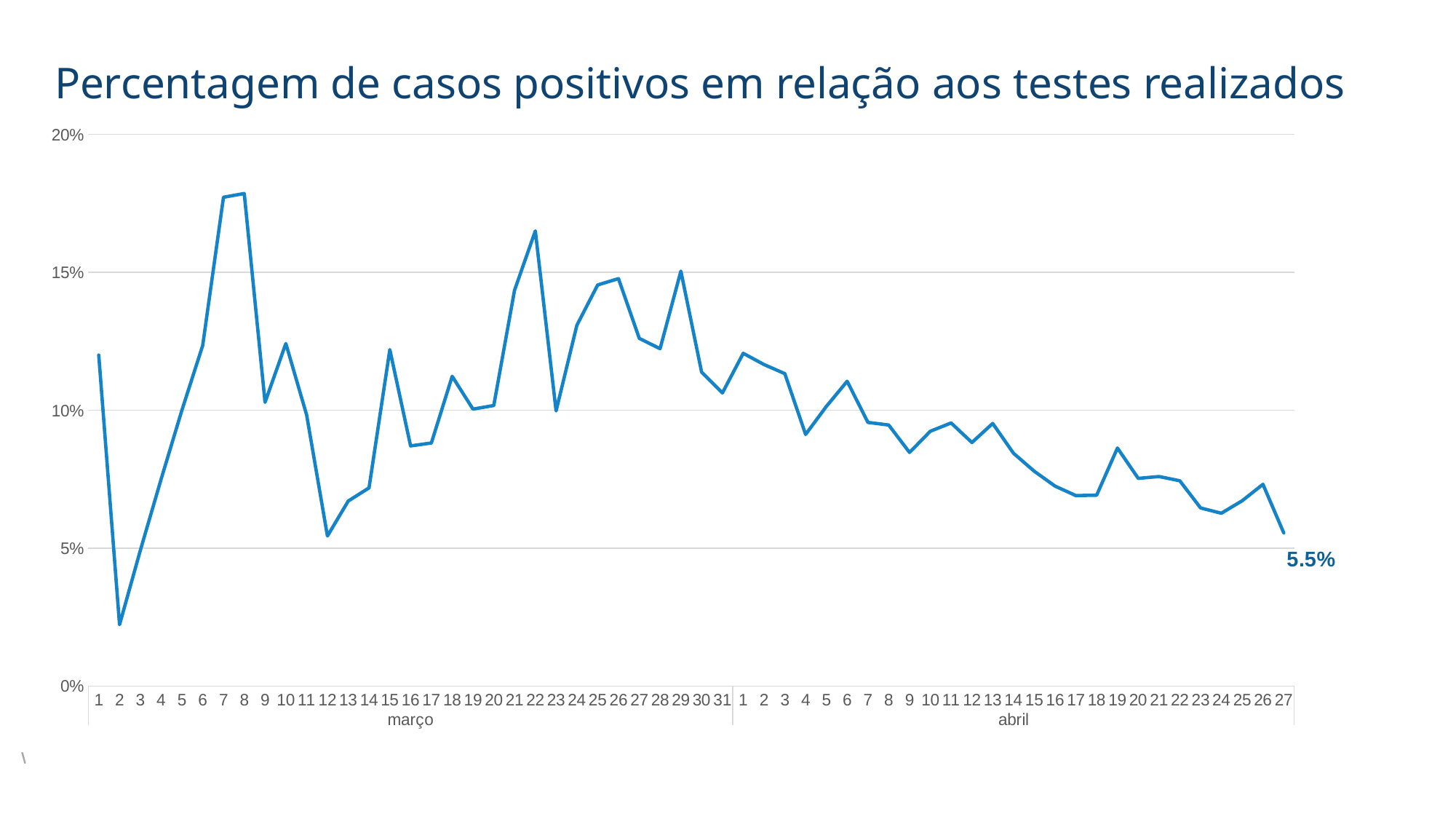
Which is larger, the value for 8 março or the value for 22 março? 8 março What is the value shown for 27 abril, the last point on the chart? 5.5% Do the values generally rise or fall across the month of abril? fall Is the value for 1 abril greater or less than 10%? greater Is the value for 8 março greater or less than 15%? greater What is the title of the chart? Percentagem de casos positivos em relação aos testes realizados How many daily data points are plotted on the chart? 58 Is the value for 2 março greater or less than 5%? less Which day has the lowest value on the chart? 2 março What kind of chart is shown on the slide? line chart